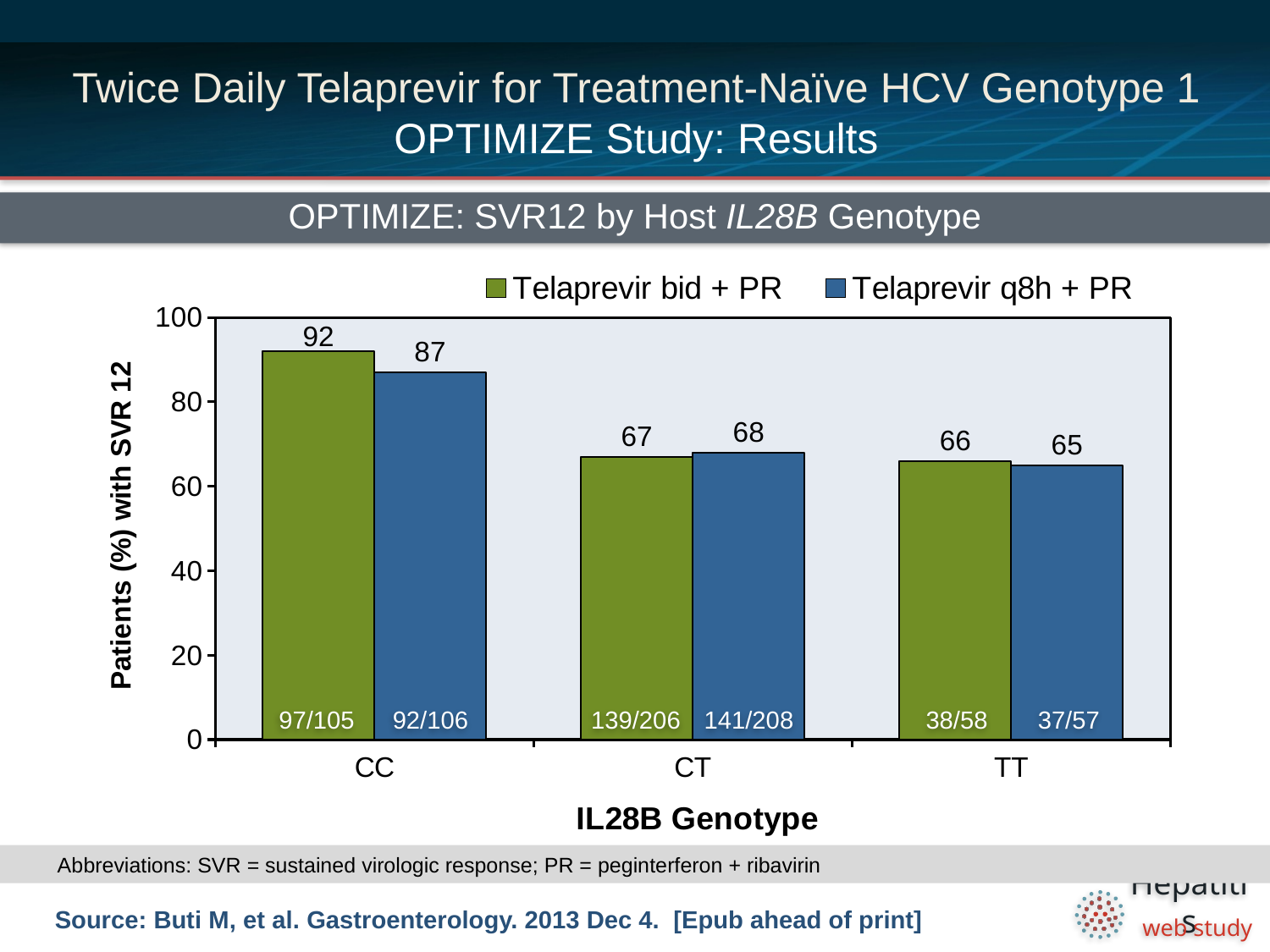
In the CC genotype group, which series has the higher SVR12 rate, Telaprevir bid + PR or Telaprevir q8h + PR? Telaprevir bid + PR How many IL28B genotype categories are shown on the x axis? 3 How many series does the legend list? 2 What fraction of patients is shown inside the Telaprevir q8h + PR bar for the CT genotype? 141/208 What is the SVR12 rate for Telaprevir q8h + PR in the TT genotype group? 65 Which IL28B genotype has the lowest SVR12 rate for Telaprevir q8h + PR? TT What is the label of the y axis? Patients (%) with SVR 12 What is the difference between the Telaprevir bid + PR and Telaprevir q8h + PR SVR12 rates in the CC genotype group? 5 What kind of chart is shown on the slide? bar chart Which IL28B genotype has the highest SVR12 rate for Telaprevir bid + PR? CC Is the SVR12 rate for Telaprevir bid + PR in the TT genotype group greater or less than 80? less What is the SVR12 rate for Telaprevir bid + PR in the CC genotype group? 92